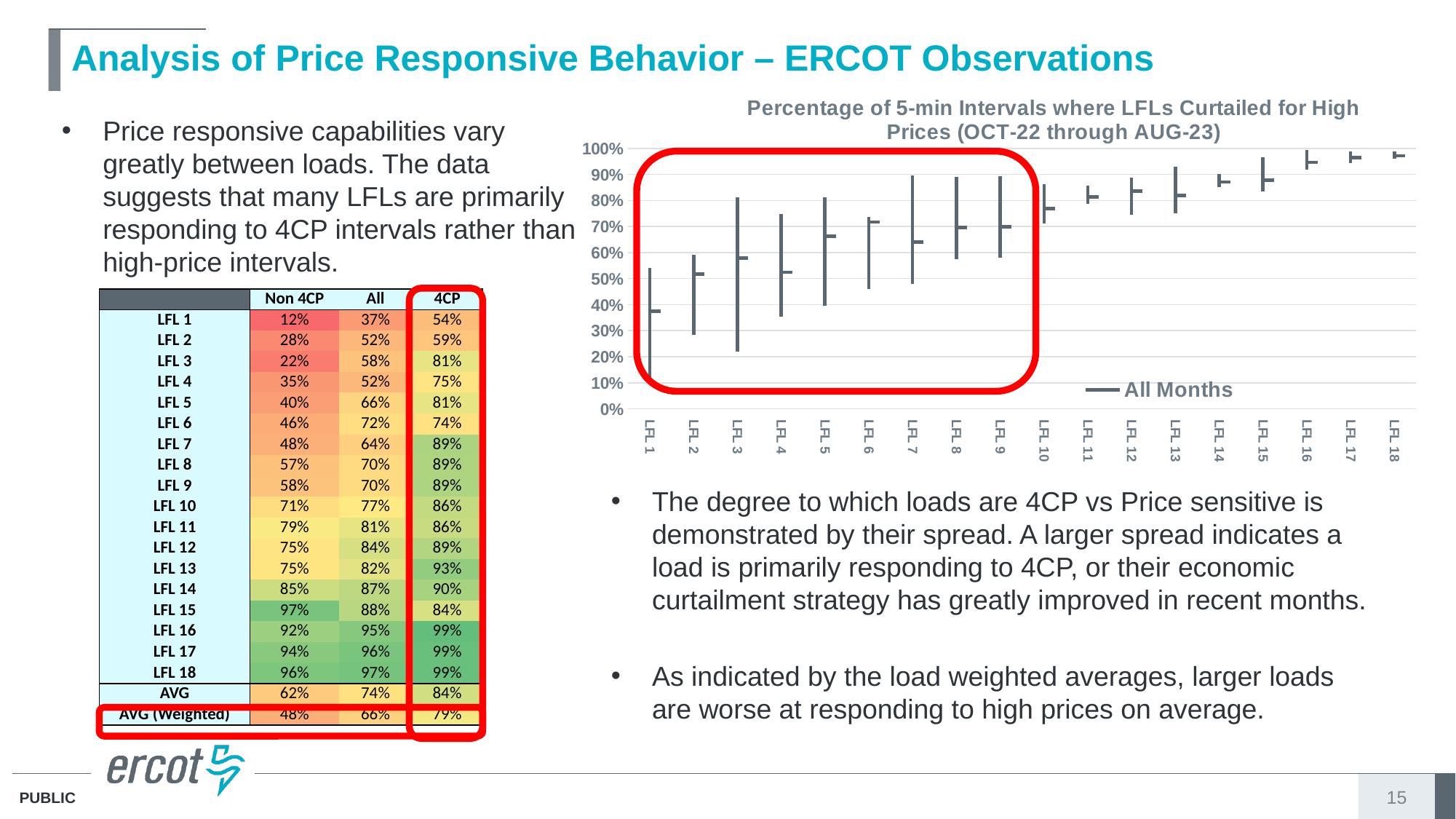
How many series does the chart legend list? 1 Is the marker value for LFL 1 in the chart greater or less than 50%? less Which has the larger marker value in the chart, LFL 1 or LFL 10? LFL 10 What series name does the chart legend list? All Months Do the marker values in the chart generally rise or fall from LFL 1 to LFL 18? rise What is the title of the chart? Percentage of 5-min Intervals where LFLs Curtailed for High Prices (OCT-22 through AUG-23) Which LFL has the lowest marker value in the chart? LFL 1 Is the marker value for LFL 16 in the chart greater or less than 90%? greater How many LFL categories are shown on the x axis of the chart? 18 Is the marker value for LFL 9 in the chart greater or less than 60%? greater What kind of chart is shown on the slide? high-low (stock) chart